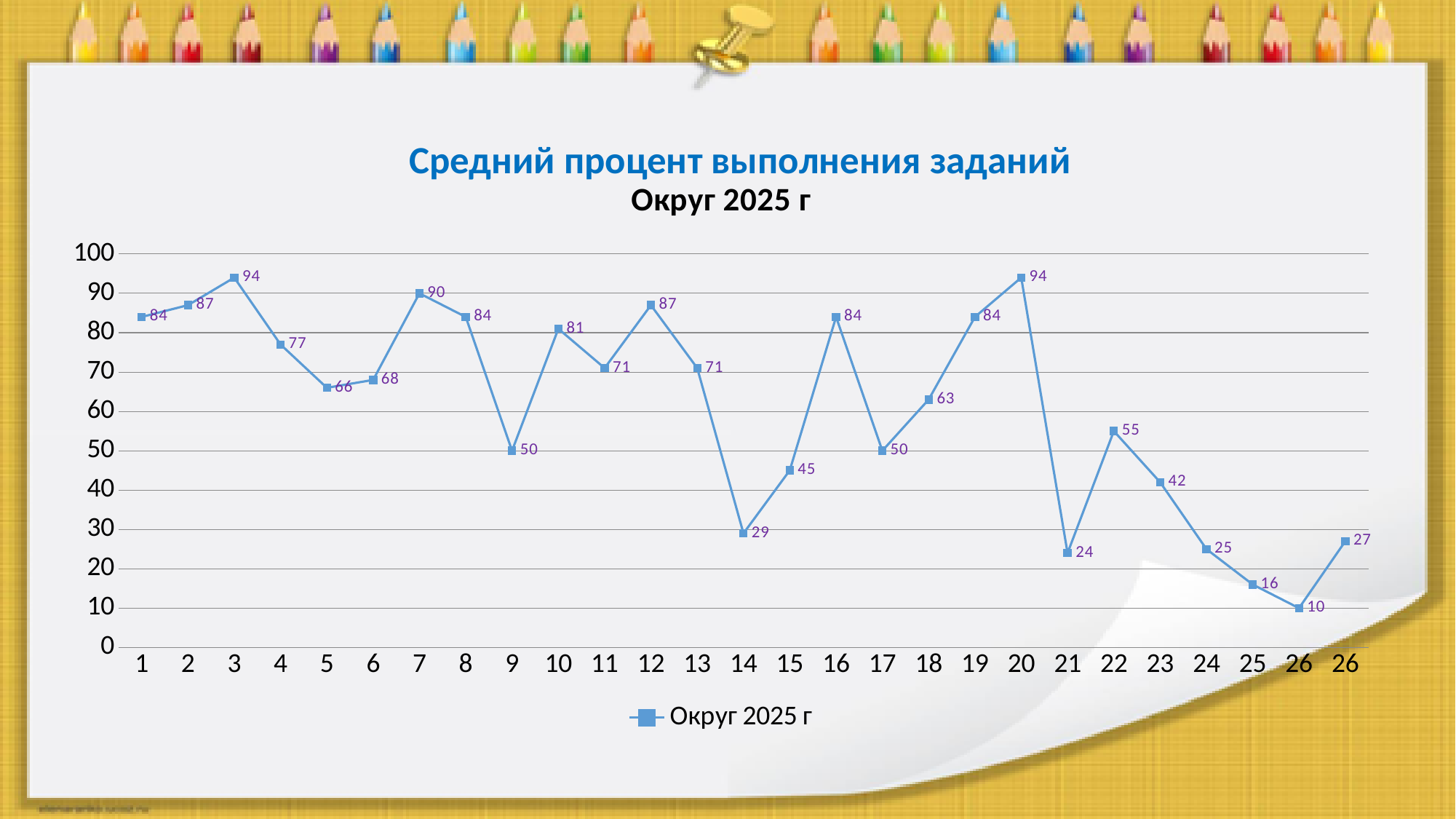
What kind of chart is shown on the slide? line chart How many data points are plotted on the chart? 27 How many series does the legend list? 1 Which has the larger value, category 7 or category 8? 7 What is the value for category 21? 24 What is the difference between the values for categories 2 and 1? 3 What is the value for category 14? 29 What is the lowest value plotted on the chart? 10 Which has the larger value, category 15 or category 17? 17 What is the value for category 3? 94 What is the value for category 9? 50 What is the difference between the values for categories 20 and 21? 70